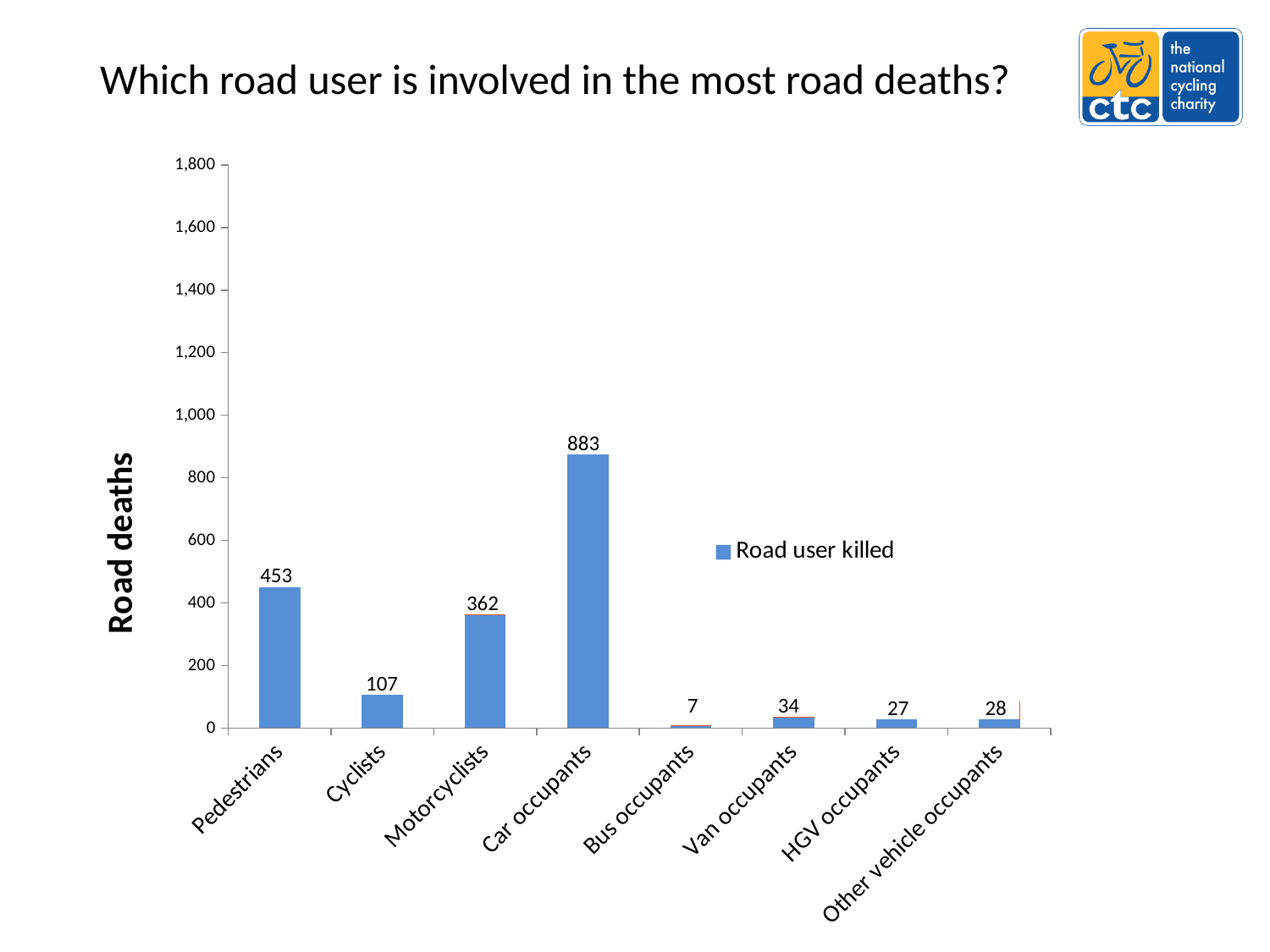
Is the value for Pedestrians greater or less than 400? greater What is the difference in road deaths between Car occupants and Pedestrians? 430 Which road user category has the lowest number of road deaths? Bus occupants Which road user category has the highest number of road deaths? Car occupants What is the label on the y axis? Road deaths Which has more road deaths, Motorcyclists or Cyclists? Motorcyclists What is the value for Bus occupants? 7 How many road deaths are shown for Cyclists? 107 What type of chart is shown on the slide? Bar chart What is the value for Pedestrians? 453 How many road user categories are shown on the x axis? 8 How many road deaths are shown for Car occupants? 883